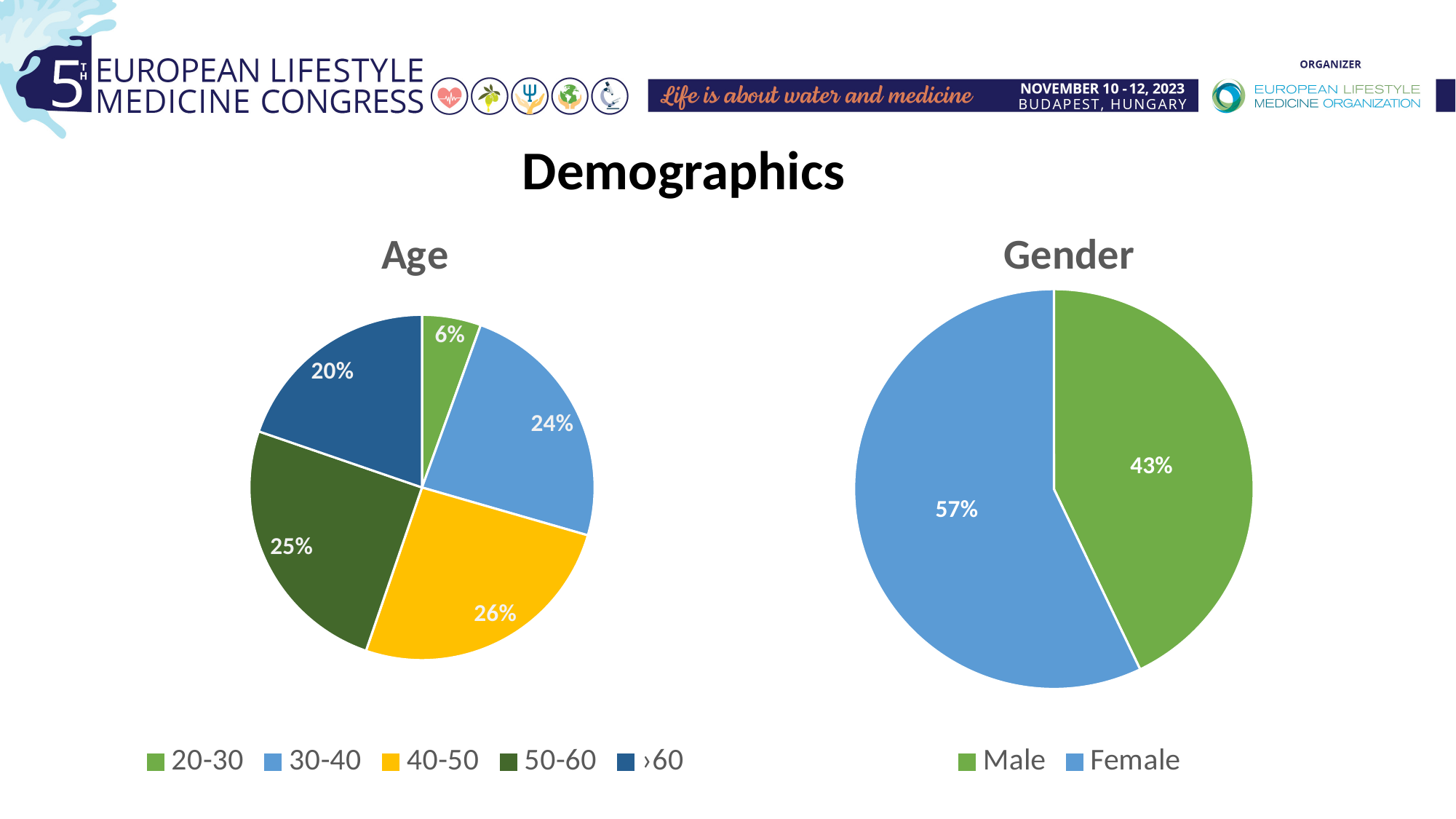
In the Age chart, how many age categories are shown? 5 In the Gender chart, what percentage is shown for Female? 57% In the Age chart, what percentage is shown for the >60 category? 20% In the Age chart, what percentage is shown for the 20-30 category? 6% In the Age chart, what is the difference between the 40-50 share and the 20-30 share? 20% In the Age chart, what percentage is shown for the 30-40 category? 24% In the Gender chart, what percentage is shown for Male? 43% In the Gender chart, which is larger, Male or Female? Female In the Gender chart, what is the difference between the Female and Male shares? 14% In the Age chart, which age group has the largest share? 40-50 In the Age chart, which age group has the smallest share? 20-30 What type of chart is the Gender chart? Pie chart